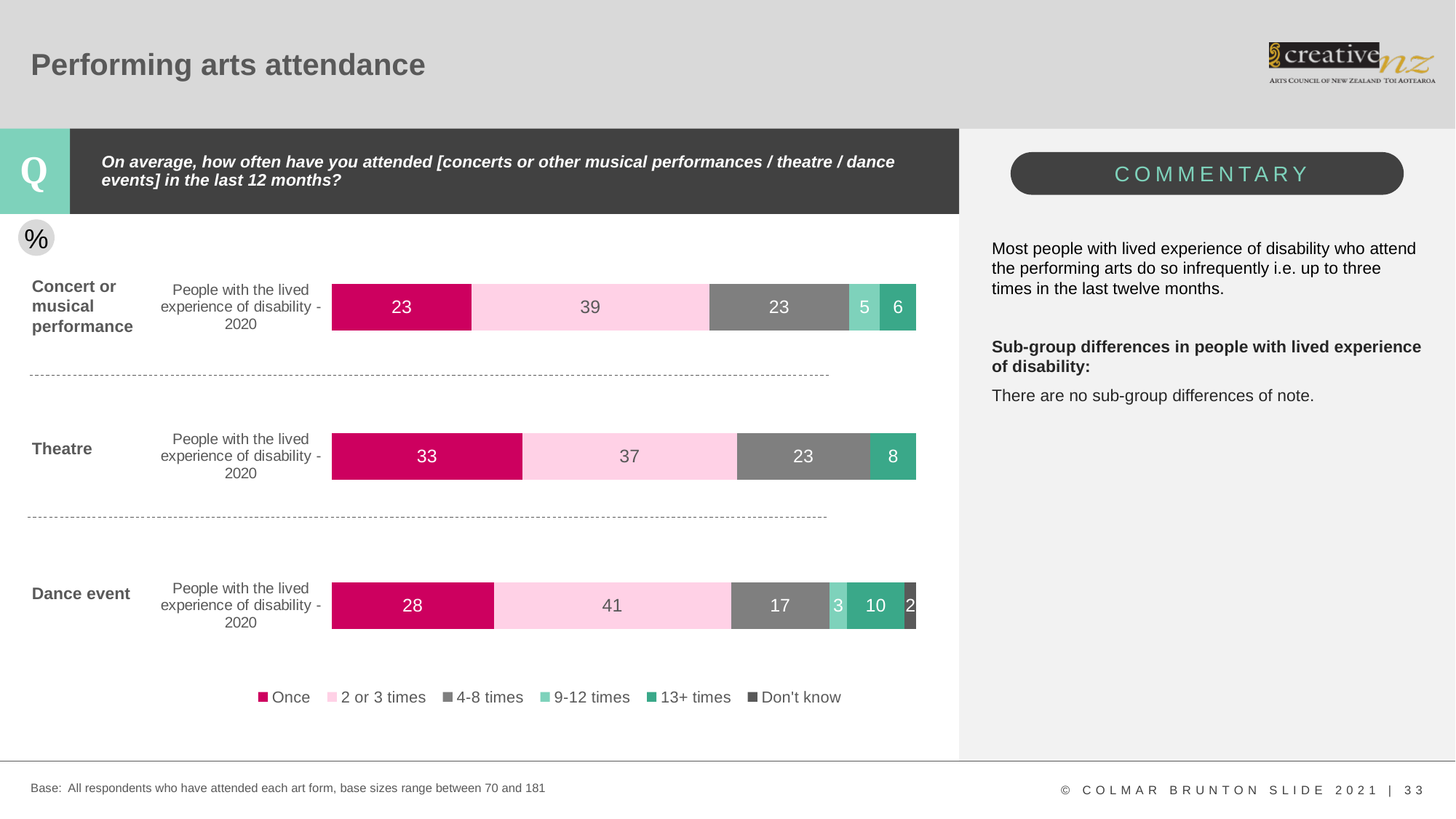
In the Theatre chart, what is the difference between the 'Once' value and the '4-8 times' value? 10 How many art forms (bars) are shown on the slide? 3 In the Concert or musical performance chart, what percentage of people with lived experience of disability attended once? 23 In the Dance event chart, what is the total of all the labelled segments in the bar? 101 Is the 'Once' value larger in the Theatre chart or the Dance event chart? Theatre In the Dance event chart, what is the value for '13+ times'? 10 In the Theatre chart, what is the value for '2 or 3 times'? 37 In the Dance event chart, which attendance frequency has the highest value? 2 or 3 times What kind of chart is used to show the attendance frequencies? Stacked bar chart Which legend entry is shown in the darkest grey colour? Don't know How many series does the legend list? 6 In the Concert or musical performance chart, which attendance frequency has the lowest value? 9-12 times